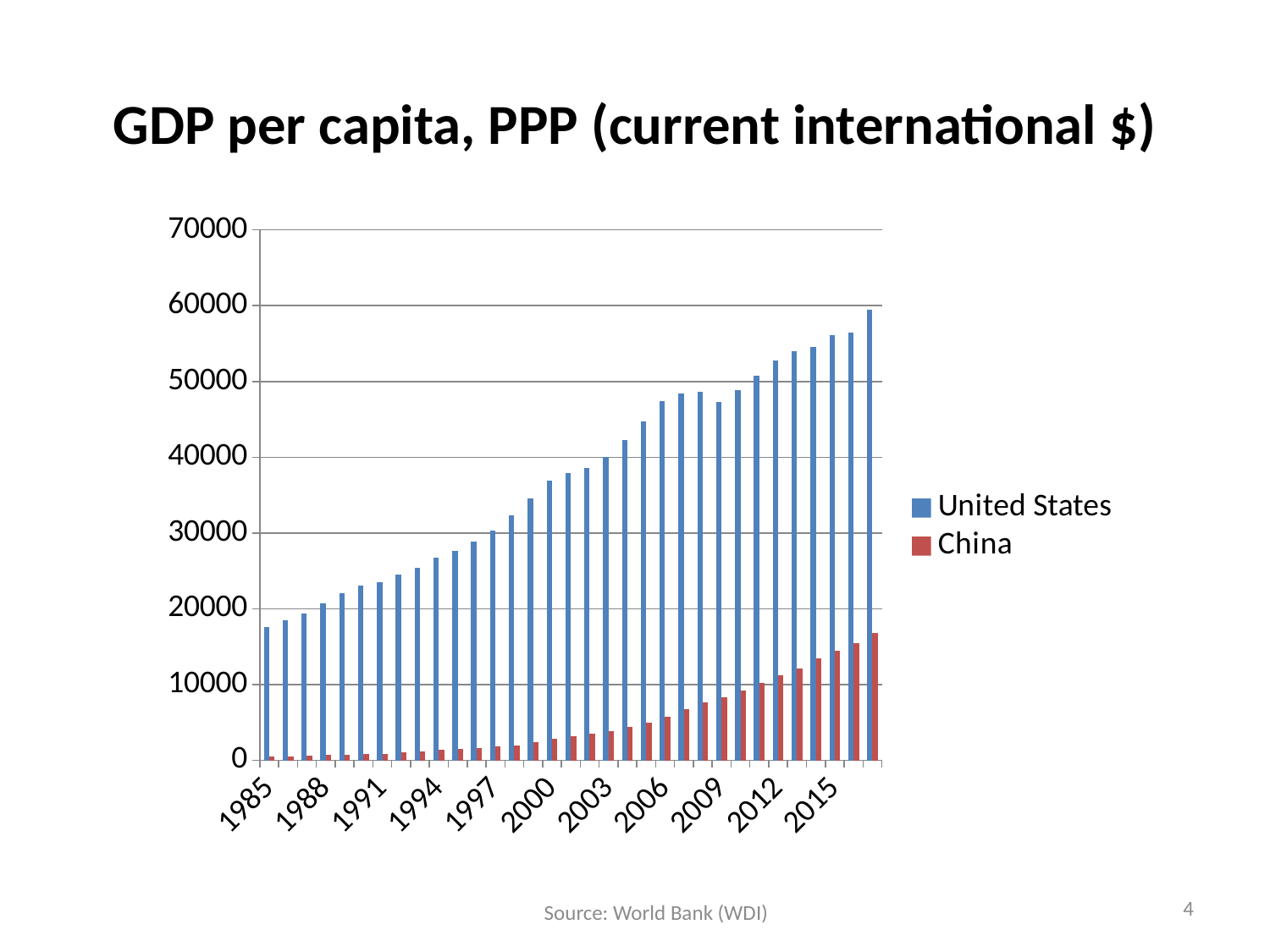
What kind of chart is shown on the slide? bar chart Is the value for China in 2000 greater or less than 10000? less Is the value for the United States in 1985 greater or less than 20000? less Which colour represents China in the chart? red Is the value for China in 2015 greater or less than 10000? greater What is the title of the chart? GDP per capita, PPP (current international $) Do the values for the United States generally rise or fall from 1985 to the last year shown? rise How many series does the legend list? 2 In 2015, which is larger, the value for the United States or the value for China? United States